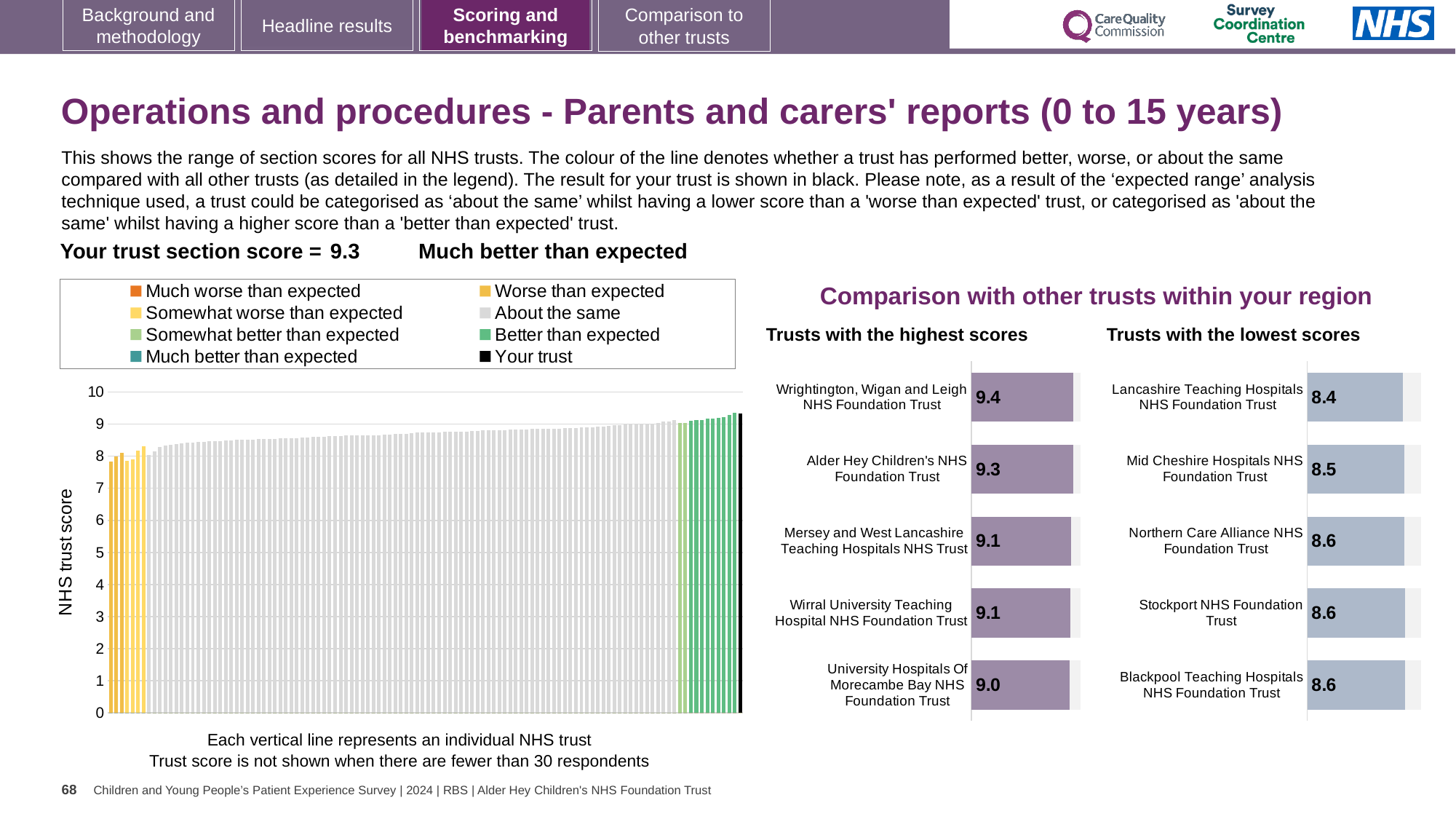
In the 'Trusts with the lowest scores' chart, which has the larger score: Mid Cheshire Hospitals NHS Foundation Trust or Lancashire Teaching Hospitals NHS Foundation Trust? Mid Cheshire Hospitals NHS Foundation Trust In the 'Trusts with the highest scores' chart, which trust has the highest score? Wrightington, Wigan and Leigh NHS Foundation Trust In the large chart on the left, what is the section score for your trust (the black bar)? 9.3 In the 'Trusts with the lowest scores' chart, what is the score for Stockport NHS Foundation Trust? 8.6 In the 'Trusts with the highest scores' chart, what is the score for Wrightington, Wigan and Leigh NHS Foundation Trust? 9.4 In the large chart on the left, do the trust scores rise or fall from left to right along the x axis? Rise How many trusts are shown in the 'Trusts with the highest scores' chart? 5 In the 'Trusts with the highest scores' chart, what is the difference between the scores of Wrightington, Wigan and Leigh NHS Foundation Trust and University Hospitals Of Morecambe Bay NHS Foundation Trust? 0.4 In the 'Trusts with the lowest scores' chart, what is the score for Lancashire Teaching Hospitals NHS Foundation Trust? 8.4 In the 'Trusts with the lowest scores' chart, which trust has the lowest score? Lancashire Teaching Hospitals NHS Foundation Trust What type of chart is the large chart on the left showing NHS trust scores? Bar chart How many entries does the legend of the large chart on the left list? 8